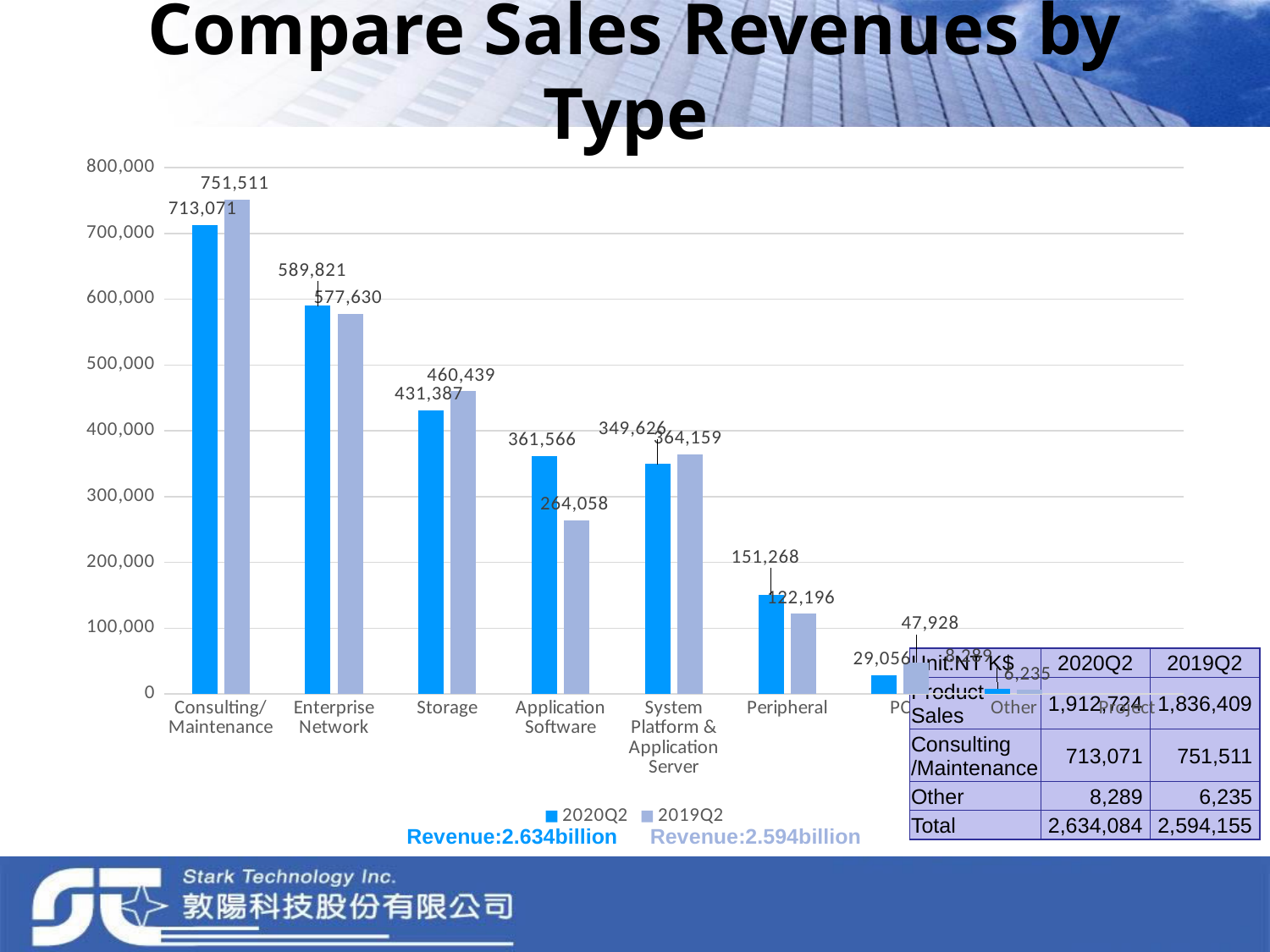
What is the 2020Q2 value for Consulting/Maintenance? 713,071 Which category has the highest 2019Q2 value? Consulting/Maintenance What is the difference between the 2019Q2 and 2020Q2 values for Consulting/Maintenance? 38,440 How many series does the legend list? 2 What is the 2019Q2 value for Peripheral? 122,196 For Enterprise Network, which is larger: the 2020Q2 value or the 2019Q2 value? 2020Q2 What kind of chart is shown on the slide? Bar chart What is the 2019Q2 value for Storage? 460,439 Which category has the highest 2020Q2 value? Consulting/Maintenance What is the 2020Q2 value for Application Software? 361,566 Is the 2020Q2 value for Peripheral greater or less than 200,000? less What is the difference between the 2020Q2 and 2019Q2 values for Application Software? 97,508